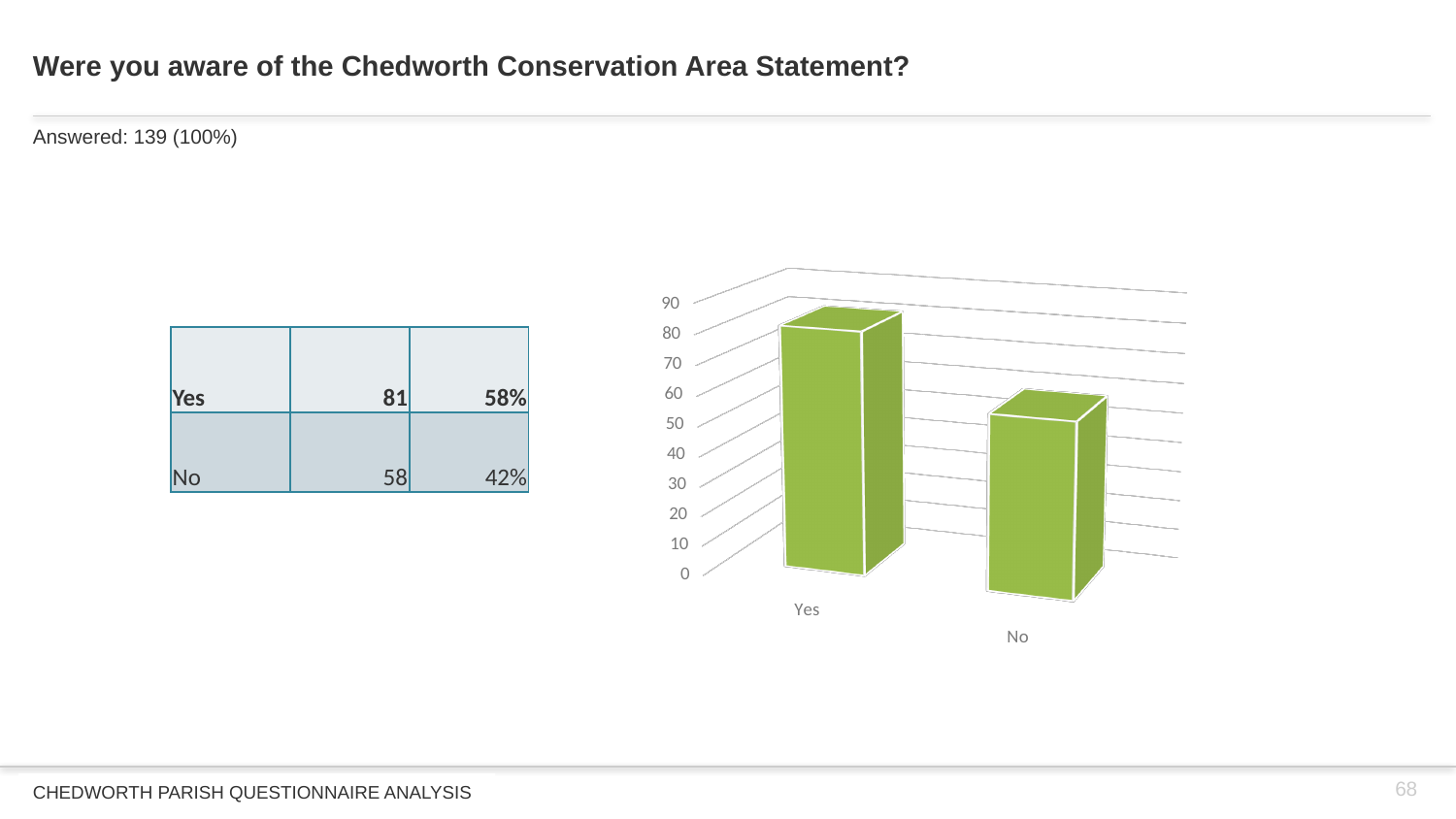
Is the bar for Yes greater or less than 70? greater Using the counts in the table, what is the difference between the Yes and No responses? 23 What kind of chart is shown on the slide? bar chart Is the bar for No greater or less than 70? less Which is larger, the bar for Yes or the bar for No? Yes Which category has the lowest bar in the chart? No How many categories are shown on the x axis of the chart? 2 Which category has the highest bar in the chart? Yes Is the bar for No greater or less than 40? greater According to the table on the slide, how many respondents answered Yes? 81 What is the highest value shown on the chart's vertical axis? 90 According to the table on the slide, what percentage of respondents answered No? 42%